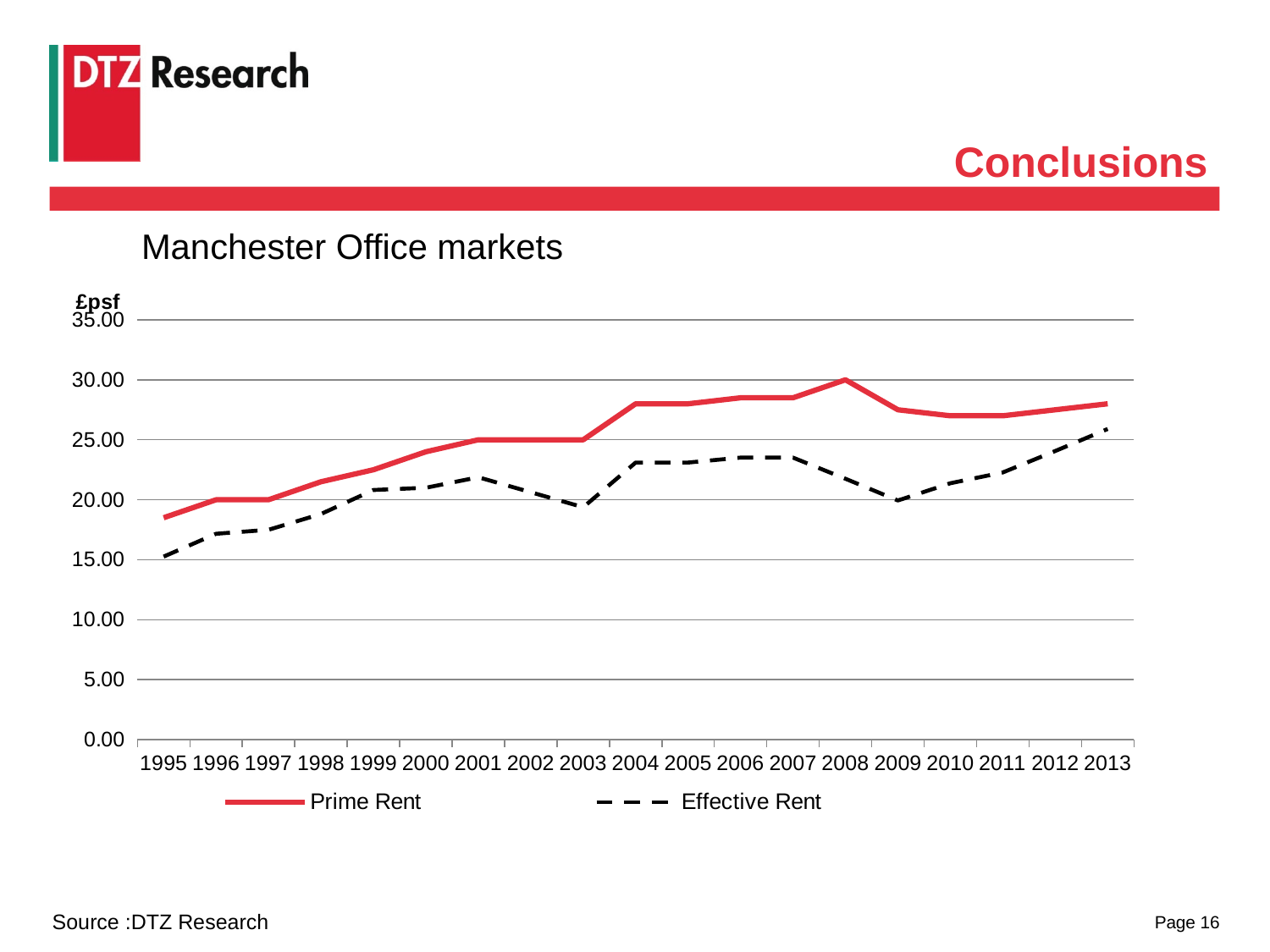
In which year is Effective Rent lowest? 1995 In which year is Prime Rent highest? 2008 Which is larger, Prime Rent in 2008 or Prime Rent in 2009? 2008 How many years are shown on the x axis? 19 Is the Effective Rent value for 2013 greater or less than 25.00? greater What kind of chart is shown on the slide? line chart Which is larger, Effective Rent in 2004 or Effective Rent in 2009? 2004 Is the Prime Rent value for 1995 greater or less than 20.00? less Overall, does Prime Rent rise or fall from 1995 to 2013? rise How many series does the legend list? 2 Is the Effective Rent value for 2003 greater or less than 20.00? less What unit is shown on the y axis of the chart? £psf